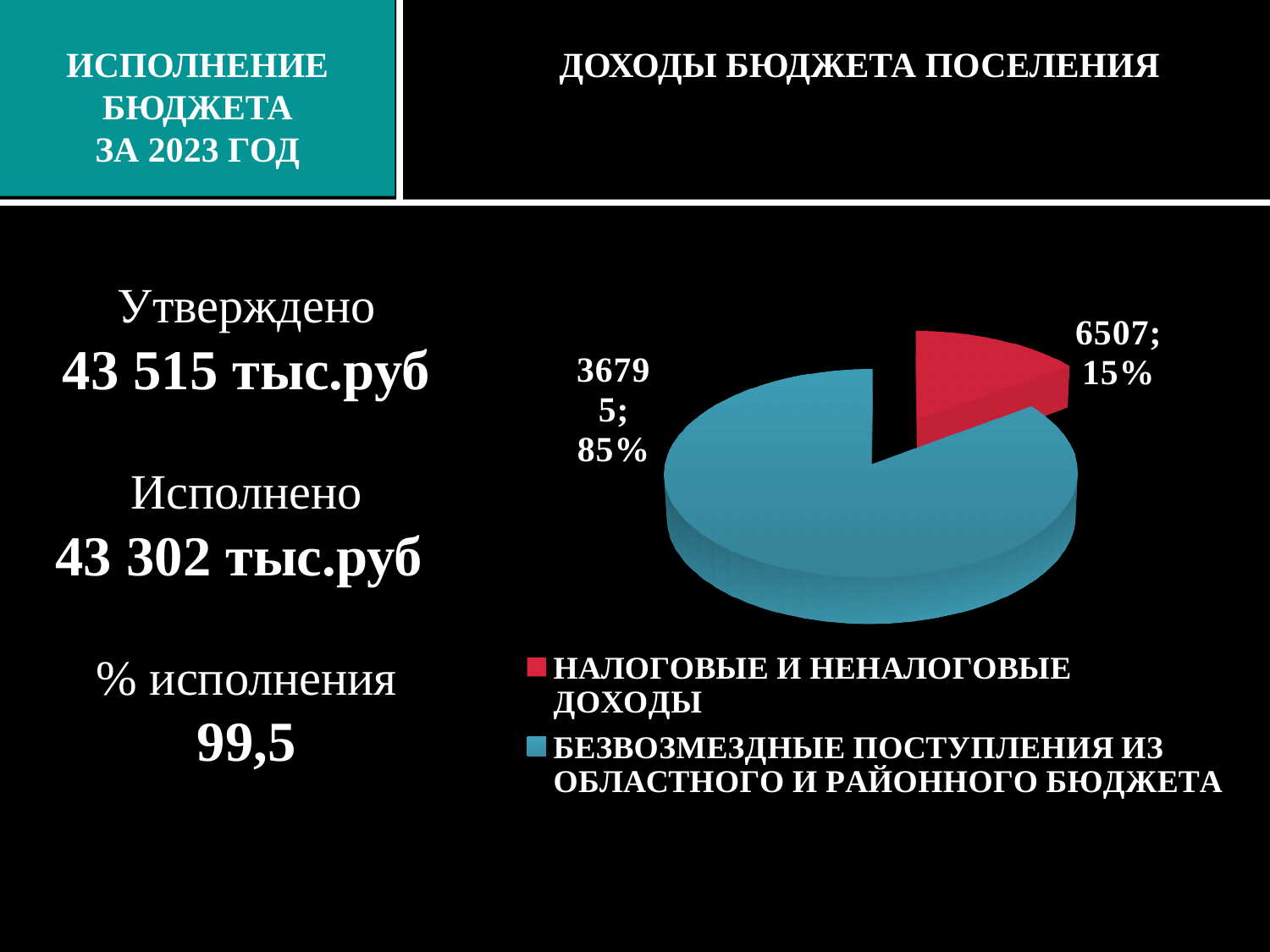
How many slices does the pie chart have? 2 How many entries does the chart legend list? 2 What is the difference between the values for БЕЗВОЗМЕЗДНЫЕ ПОСТУПЛЕНИЯ ИЗ ОБЛАСТНОГО И РАЙОННОГО БЮДЖЕТА and НАЛОГОВЫЕ И НЕНАЛОГОВЫЕ ДОХОДЫ? 30288 What is the title of the chart? ДОХОДЫ БЮДЖЕТА ПОСЕЛЕНИЯ Which category has the smallest slice of the pie? НАЛОГОВЫЕ И НЕНАЛОГОВЫЕ ДОХОДЫ What share of the pie does НАЛОГОВЫЕ И НЕНАЛОГОВЫЕ ДОХОДЫ represent? 15% What colour is the slice for НАЛОГОВЫЕ И НЕНАЛОГОВЫЕ ДОХОДЫ? red What share of the pie does БЕЗВОЗМЕЗДНЫЕ ПОСТУПЛЕНИЯ ИЗ ОБЛАСТНОГО И РАЙОННОГО БЮДЖЕТА represent? 85% Which category has the largest slice of the pie? БЕЗВОЗМЕЗДНЫЕ ПОСТУПЛЕНИЯ ИЗ ОБЛАСТНОГО И РАЙОННОГО БЮДЖЕТА What value is shown for БЕЗВОЗМЕЗДНЫЕ ПОСТУПЛЕНИЯ ИЗ ОБЛАСТНОГО И РАЙОННОГО БЮДЖЕТА? 36795 What type of chart is shown on the slide? pie chart What value is shown for НАЛОГОВЫЕ И НЕНАЛОГОВЫЕ ДОХОДЫ? 6507